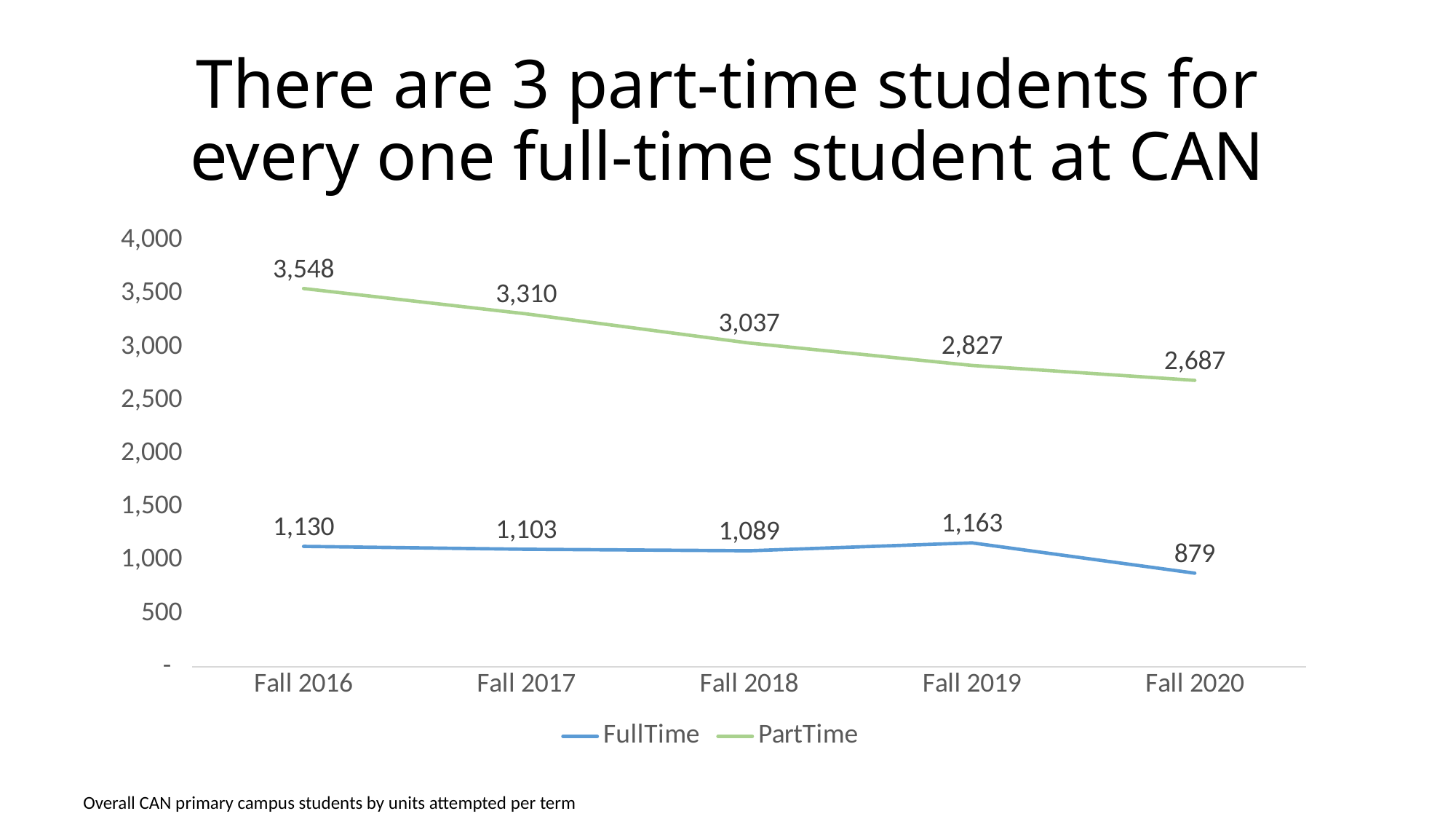
By how much did the PartTime value fall from Fall 2016 to Fall 2020? 861 What kind of chart is shown on the slide? Line chart Which is larger, the FullTime value in Fall 2019 or in Fall 2020? Fall 2019 In which term is the FullTime value lowest? Fall 2020 In which term is the PartTime value highest? Fall 2016 What is the difference between the PartTime and FullTime values in Fall 2018? 1,948 Does the PartTime series rise or fall from Fall 2016 to Fall 2020? Fall What is the PartTime value for Fall 2020? 2,687 How many terms are shown on the x axis? 5 What is the PartTime value for Fall 2016? 3,548 What is the FullTime value for Fall 2019? 1,163 How many series does the legend list? 2